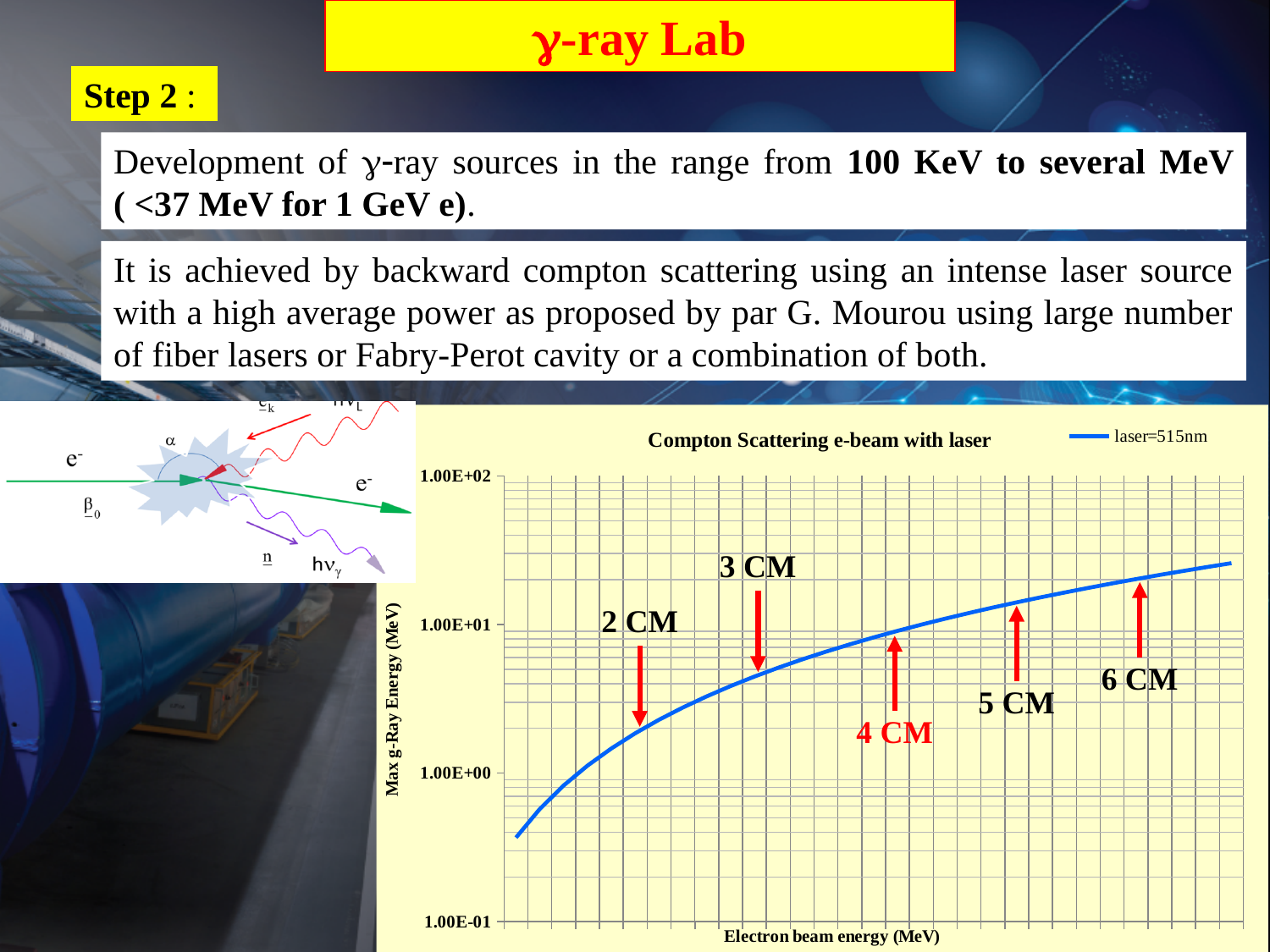
What kind of chart is shown on the slide? line chart Is the Max g-Ray Energy at the point marked "2 CM" greater or less than 1.00E+01 MeV? less What series name is shown in the chart legend? laser=515nm Is the Max g-Ray Energy at the point marked "6 CM" greater or less than 1.00E+01 MeV? greater Is the Max g-Ray Energy at the point marked "3 CM" greater or less than 1.00E+01 MeV? less Does the Max g-Ray Energy rise or fall as the electron beam energy increases along the x axis? rise How many series does the chart legend list? 1 Which marked point has the higher Max g-Ray Energy, "2 CM" or "6 CM"? 6 CM What is the title of the chart? Compton Scattering e-beam with laser